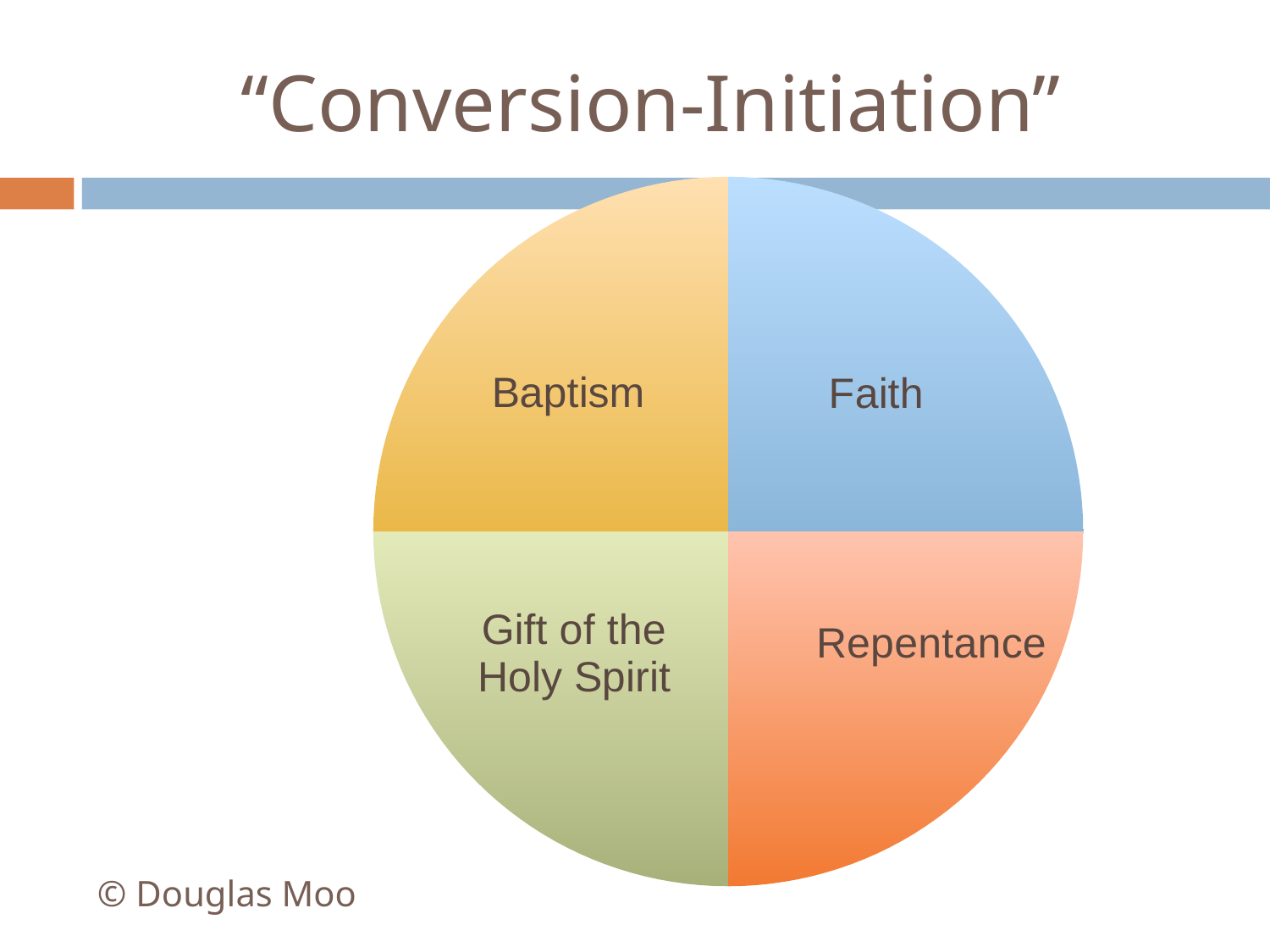
Which slice of the pie chart is coloured blue? Faith Which slice of the pie chart is labelled in the lower-right quarter? Repentance Which slice of the pie chart is labelled in the upper-right quarter? Faith How many slices does the pie chart have? 4 Which slice of the pie chart is labelled in the lower-left quarter? Gift of the Holy Spirit What kind of chart is shown on the slide? pie chart What is the title of the slide containing the pie chart? "Conversion-Initiation" Which slice of the pie chart is labelled in the upper-left quarter? Baptism